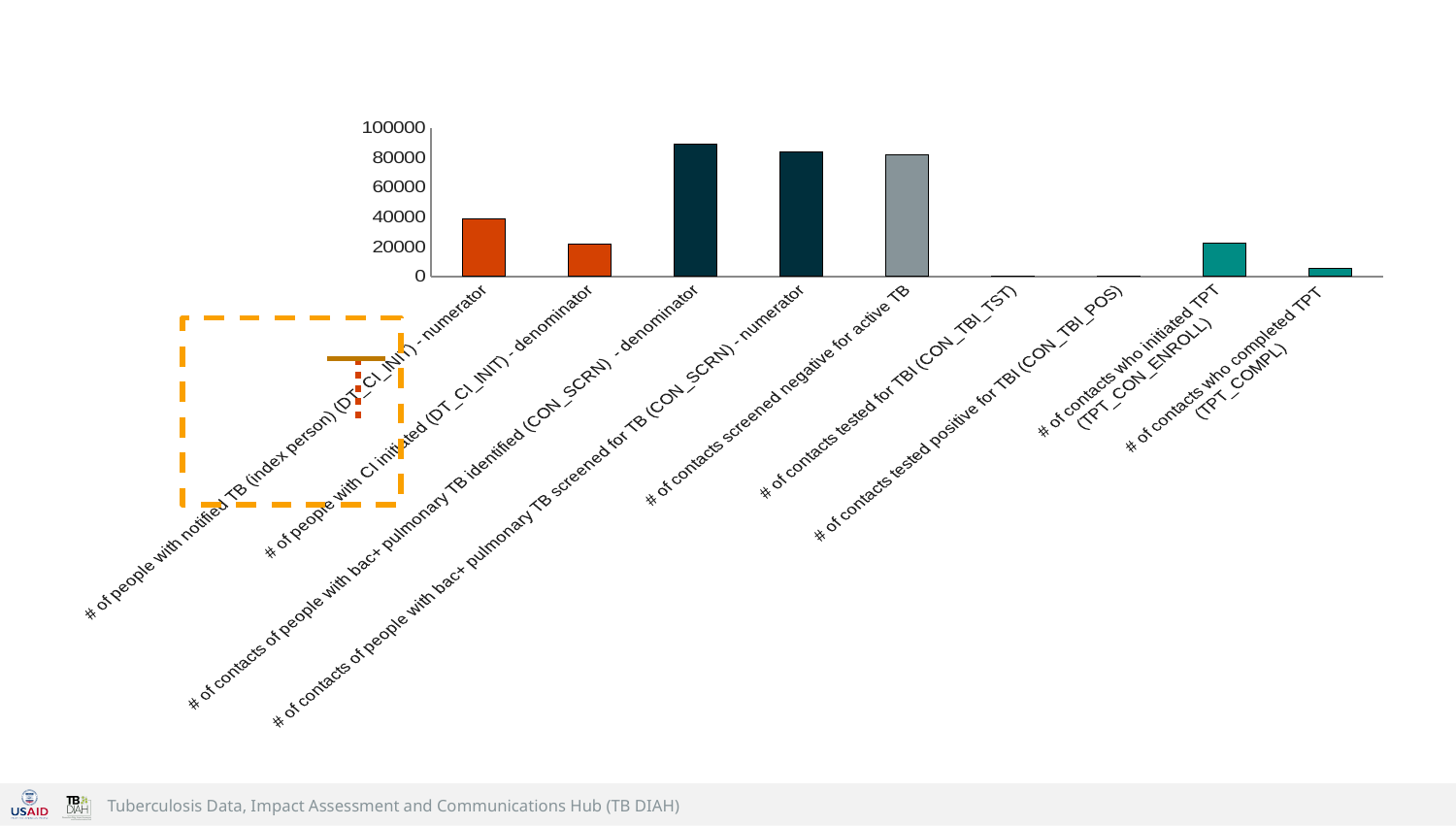
Which category has the highest bar in the chart? # of contacts of people with bac+ pulmonary TB identified (CON_SCRN) - denominator What colour are the first two bars in the chart? orange-red Is the value for '# of contacts of people with bac+ pulmonary TB identified (CON_SCRN) - denominator' greater or less than 80000? greater What is the highest tick value shown on the y axis of the chart? 100000 Is the value for '# of contacts who completed TPT (TPT_COMPL)' greater or less than 20000? less What kind of chart is shown on the slide? bar chart Is the value for '# of people with notified TB (index person) (DT_CI_INIT) - numerator' greater or less than 20000? greater Which is larger: the value for '# of contacts who initiated TPT (TPT_CON_ENROLL)' or the value for '# of contacts who completed TPT (TPT_COMPL)'? # of contacts who initiated TPT (TPT_CON_ENROLL) Which is larger: the value for '# of people with notified TB (index person) (DT_CI_INIT) - numerator' or the value for '# of people with CI initiated (DT_CI_INIT) - denominator'? # of people with notified TB (index person) (DT_CI_INIT) - numerator How many categories are plotted on the x axis of the chart? 9